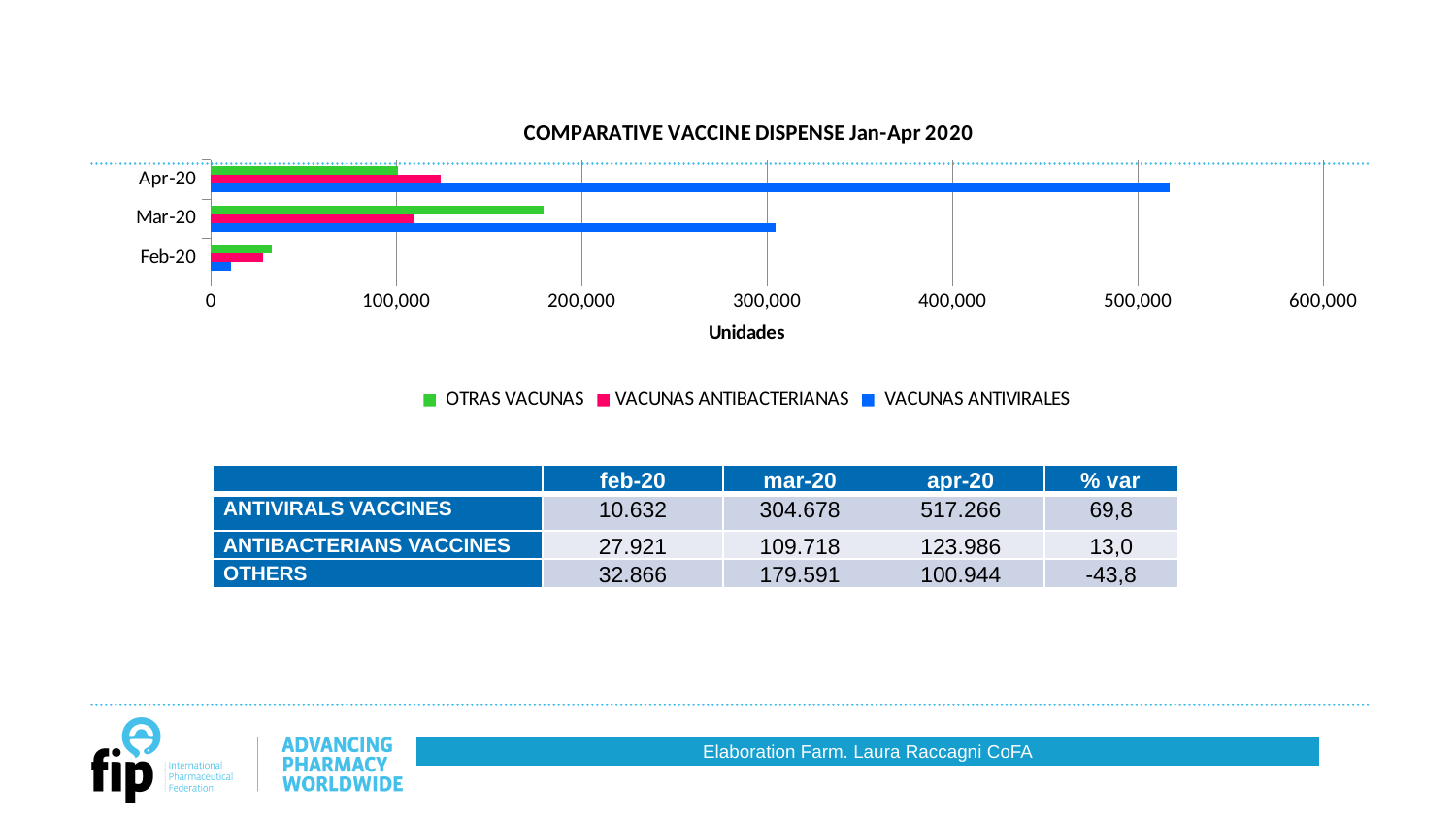
What kind of chart is shown on the slide? bar chart Is the value for OTRAS VACUNAS in Mar-20 greater or less than 200,000? less Is the value for VACUNAS ANTIVIRALES in Apr-20 greater or less than 500,000? greater Which series has the shortest bar for Feb-20? VACUNAS ANTIVIRALES How many series does the chart legend list? 3 Is the value for VACUNAS ANTIVIRALES in Mar-20 greater or less than 200,000? greater According to the table below the chart, what is the apr-20 value for ANTIVIRALS VACCINES? 517.266 Which series and month has the longest bar in the chart? VACUNAS ANTIVIRALES, Apr-20 Does the VACUNAS ANTIVIRALES series rise or fall from Feb-20 to Apr-20? rise What is the title of the chart? COMPARATIVE VACCINE DISPENSE Jan-Apr 2020 How many month categories are shown on the chart's vertical axis? 3 In Mar-20, which is larger: OTRAS VACUNAS or VACUNAS ANTIBACTERIANAS? OTRAS VACUNAS